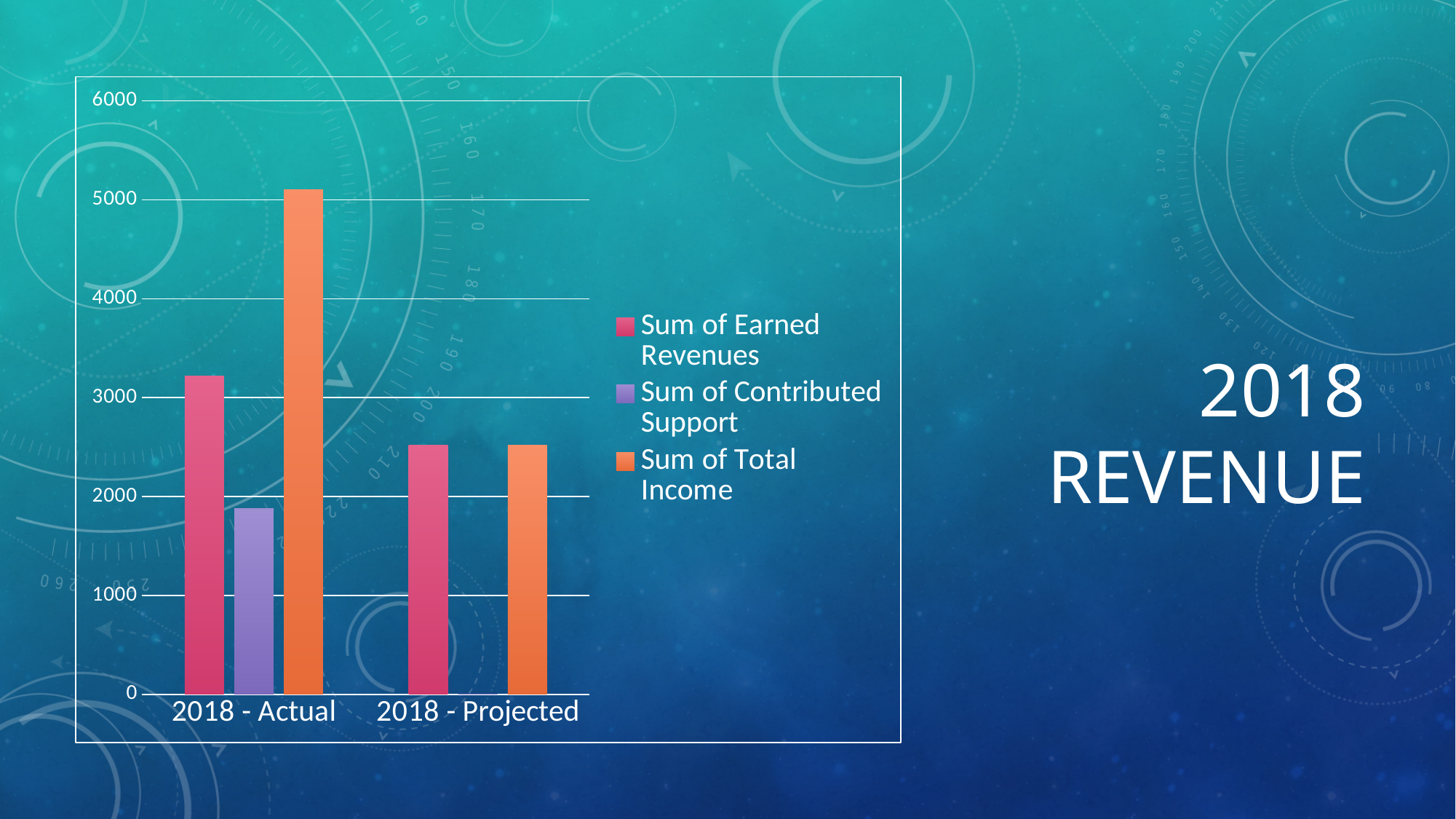
Is the value for Sum of Earned Revenues in 2018 - Actual greater or less than 3000? greater Is the value for Sum of Earned Revenues in 2018 - Projected greater or less than 2000? greater Is the value for Sum of Contributed Support in 2018 - Actual greater or less than 2000? less Which series has the lowest bar in the 2018 - Actual category? Sum of Contributed Support How many series does the chart's legend list? 3 Which is larger, Sum of Total Income for 2018 - Actual or for 2018 - Projected? 2018 - Actual How many categories are shown on the x axis of the chart? 2 Which series has the highest bar in the 2018 - Actual category? Sum of Total Income Does Sum of Earned Revenues rise or fall from 2018 - Actual to 2018 - Projected? fall What kind of chart is shown on the slide? bar chart